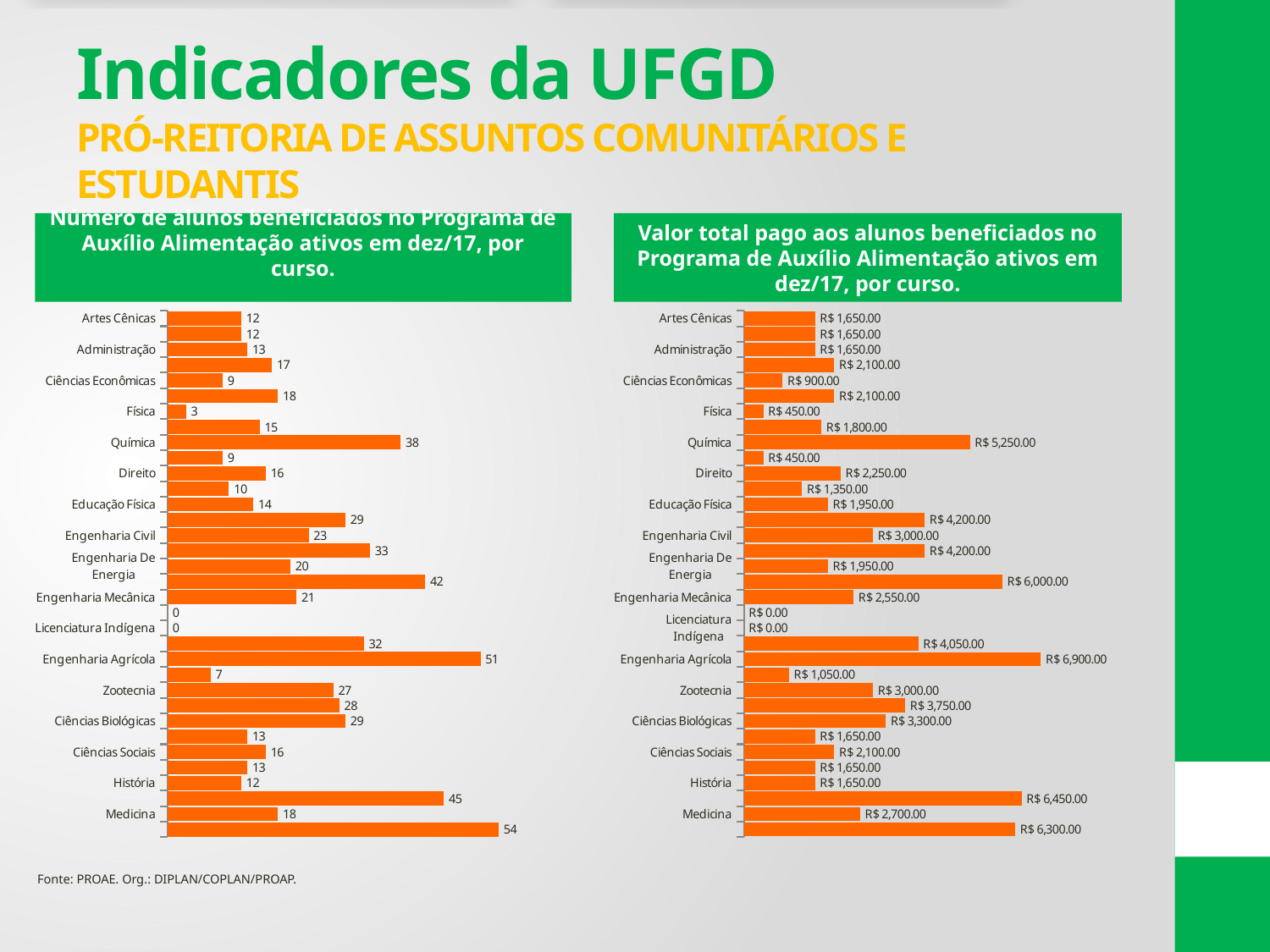
In the left chart (Número de alunos beneficiados), what is the value for Química? 38 In the right chart (Valor total pago aos alunos beneficiados), what is the value for Licenciatura Indígena? R$ 0.00 In the right chart (Valor total pago aos alunos beneficiados), what is the value for Engenharia Agrícola? R$ 6,900.00 What colour are the bars in both charts on the slide? orange In the left chart (Número de alunos beneficiados), what is the difference between the value for Engenharia Agrícola and the value for Química? 13 In the right chart (Valor total pago aos alunos beneficiados), what is the value for Química? R$ 5,250.00 In the left chart (Número de alunos beneficiados), what is the largest value shown on any bar? 54 What kind of chart is the left chart, 'Número de alunos beneficiados no Programa de Auxílio Alimentação ativos em dez/17, por curso'? bar chart In the left chart (Número de alunos beneficiados), what is the value for Física? 3 In the left chart (Número de alunos beneficiados), which is larger, the value for Química or the value for Engenharia Agrícola? Engenharia Agrícola In the right chart (Valor total pago aos alunos beneficiados), what is the largest value shown on any bar? R$ 6,900.00 In the right chart (Valor total pago aos alunos beneficiados), what is the value for Física? R$ 450.00